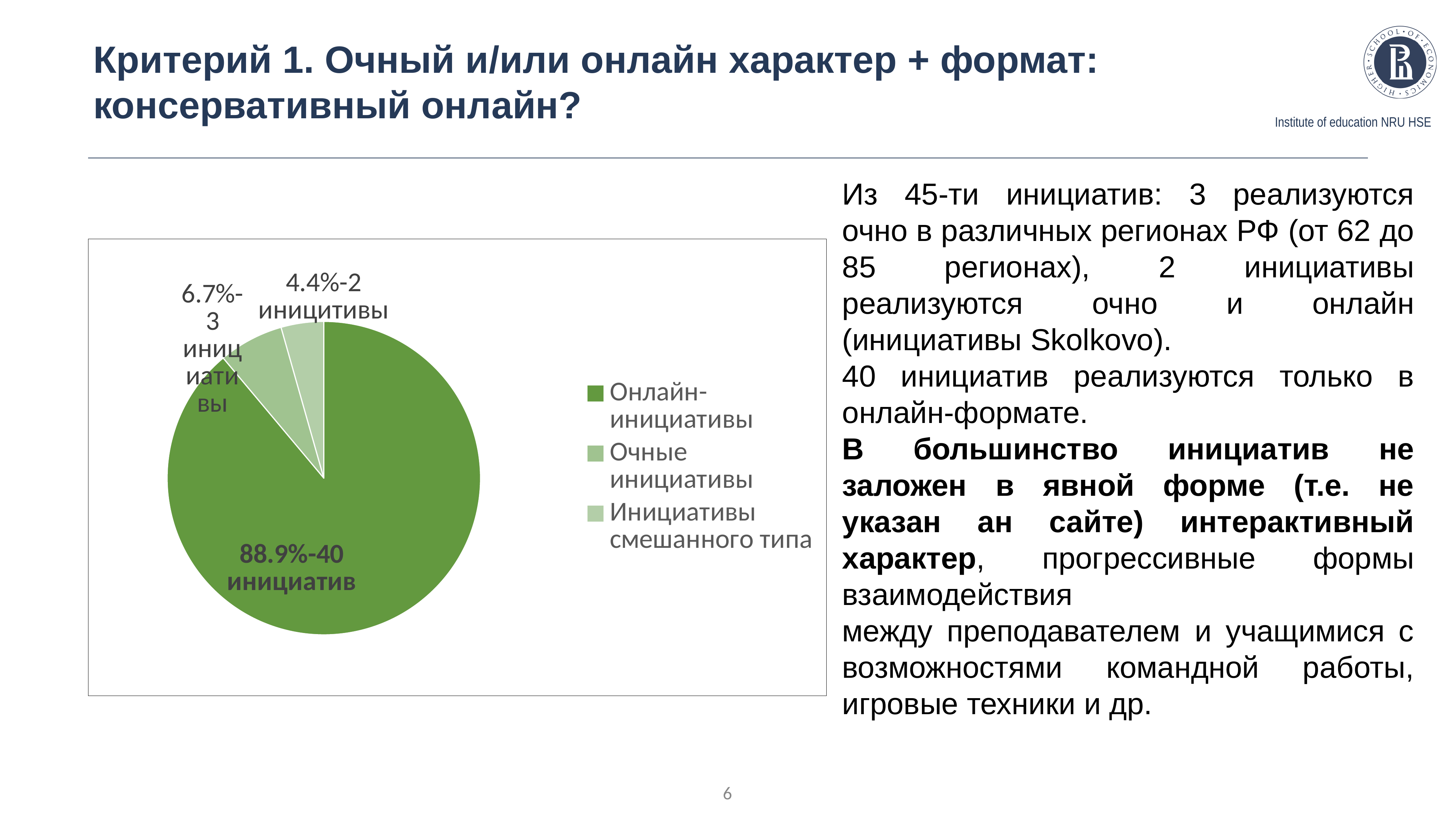
How many slices does the pie chart have? 3 What percentage share does the pie chart show for Инициативы смешанного типа? 4.4% How many initiatives does the pie chart label give for Онлайн-инициативы? 40 How many initiatives does the pie chart label give for Очные инициативы? 3 What percentage share does the pie chart show for Очные инициативы? 6.7% What percentage share does the pie chart show for Онлайн-инициативы? 88.9% Which category has the largest slice in the pie chart? Онлайн-инициативы How many entries does the legend of the pie chart list? 3 Which category has the smallest slice in the pie chart? Инициативы смешанного типа How many initiatives does the pie chart label give for Инициативы смешанного типа? 2 What kind of chart is shown on the slide? pie chart What is the difference in percentage points between the Онлайн-инициативы slice and the Очные инициативы slice? 82.2